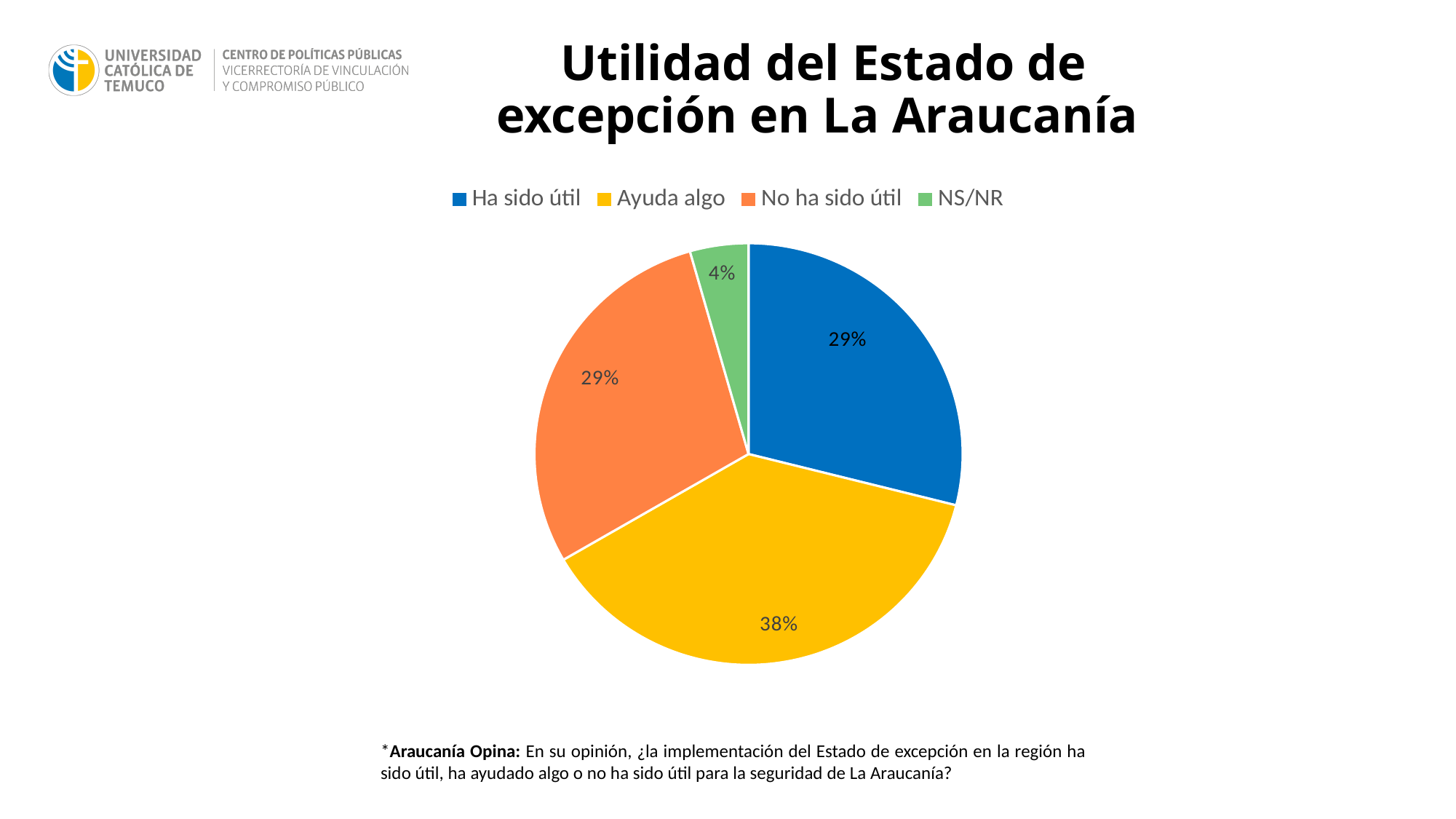
What is the title of the chart? Utilidad del Estado de excepción en La Araucanía What percentage of respondents answered "Ha sido útil"? 29% What percentage of respondents answered "Ayuda algo"? 38% Which is larger, the share for "Ayuda algo" or the share for "Ha sido útil"? Ayuda algo What type of chart is shown on the slide? pie chart What is the difference in percentage points between "Ayuda algo" and "NS/NR"? 34 Which category has the largest share of the pie? Ayuda algo What percentage of respondents answered "NS/NR"? 4% Which category has the smallest share of the pie? NS/NR How many categories does the pie chart show? 4 What colour is the slice for "No ha sido útil"? orange What percentage of respondents answered "No ha sido útil"? 29%